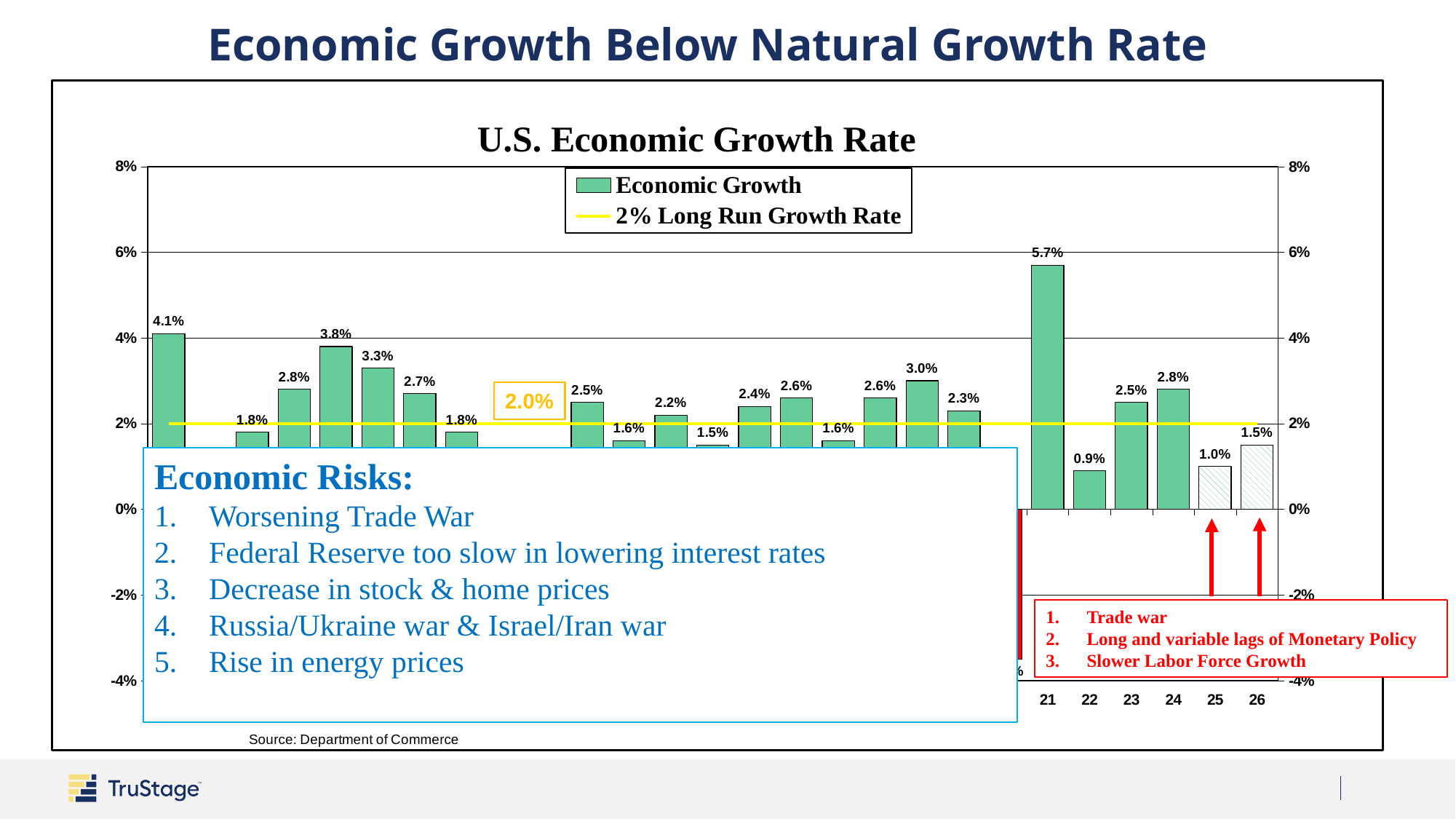
What is the title of the chart? U.S. Economic Growth Rate Is the economic growth rate for 25 greater or less than 2%? less Which year among 21 through 26 has the lowest economic growth rate? 22 What is the economic growth rate shown for 26? 1.5% Which year among 21 through 26 has the highest economic growth rate? 21 What is the economic growth rate shown for 21? 5.7% Which has a higher economic growth rate, 23 or 26? 23 What kind of chart is used to show the economic growth rate? Bar chart How many entries does the legend list? 2 What is the economic growth rate shown for 24? 2.8% What is the economic growth rate shown for 22? 0.9% What is the difference between the growth rate for 24 and the growth rate for 25? 1.8%